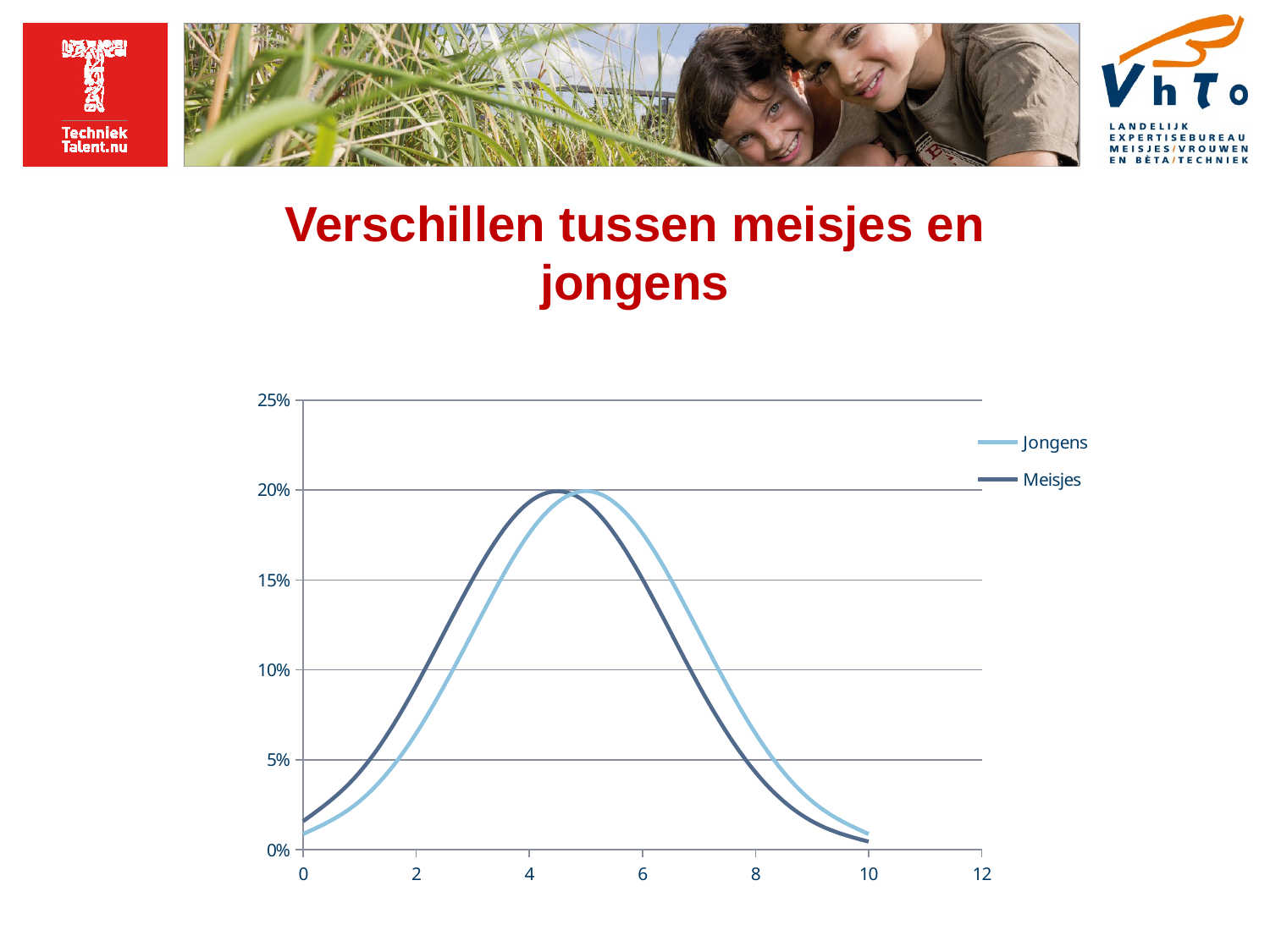
Which series is drawn in the lighter blue line? Jongens Is the value for Meisjes at x = 4 greater or less than 15%? greater Is the value for Jongens at x = 0 greater or less than 5%? less At x = 8, which series has the higher value, Jongens or Meisjes? Jongens Which two series are listed in the legend? Jongens and Meisjes Is the peak value of the Meisjes line greater or less than 25%? less Which series reaches its peak at a lower x value, Jongens or Meisjes? Meisjes At x = 2, which series has the higher value, Jongens or Meisjes? Meisjes Does the Jongens line rise or fall between x = 6 and x = 10? fall How many series does the legend list? 2 What kind of chart is shown on the slide? Line chart